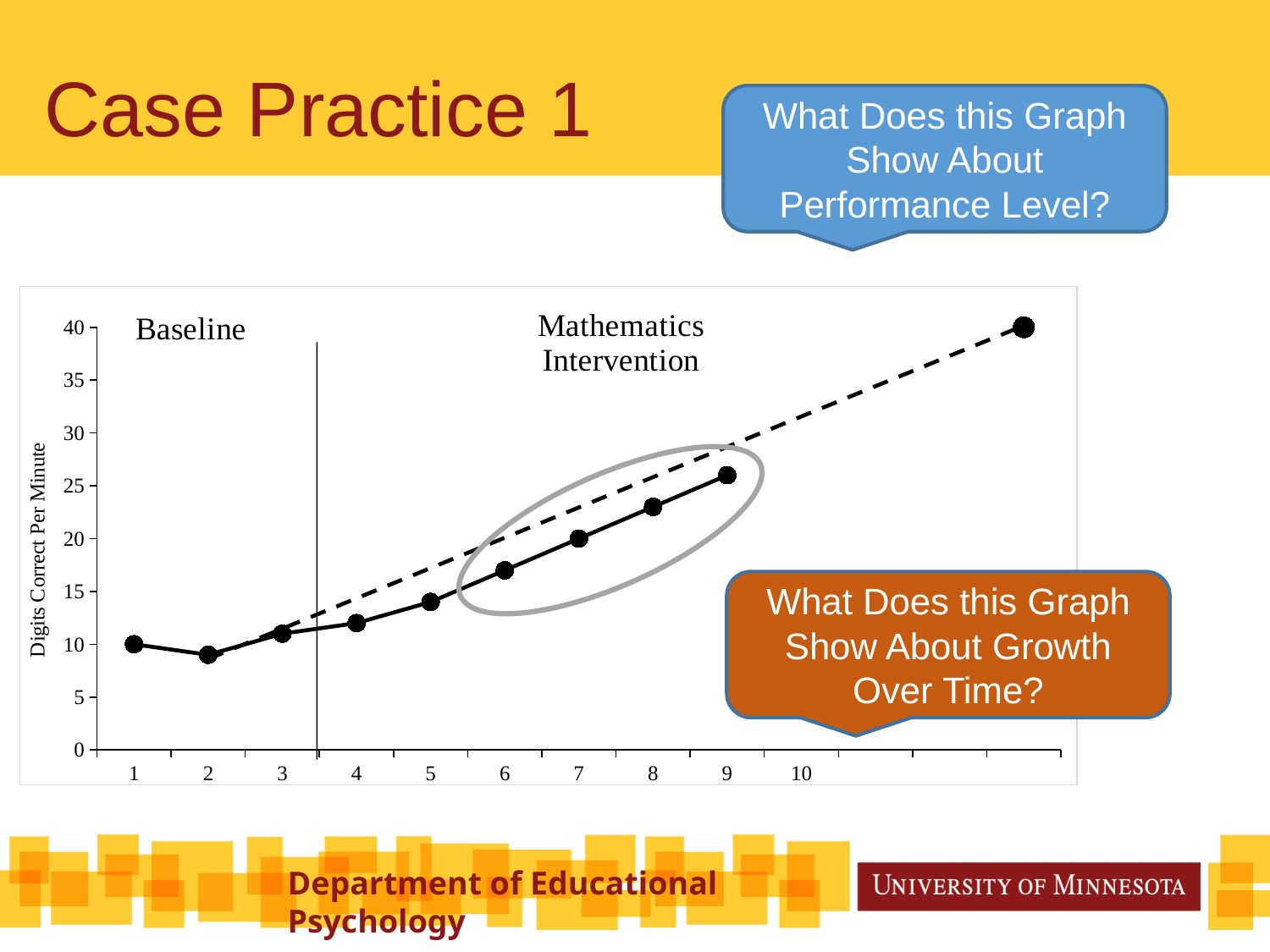
What type of chart is shown on the slide? line chart What is the value of the data point at session 7? 20 What value does the dashed goal line reach at its endpoint? 40 How many data points are plotted on the solid line? 9 Is the value at session 2 greater or less than 10? less Is the value at session 9 greater or less than 25? greater What is the label on the y axis of the chart? Digits Correct Per Minute Do the values on the solid line generally rise or fall during the Mathematics Intervention phase? rise Which session has the lowest value on the solid line? 2 What is the value of the first data point (session 1)? 10 Is the value at session 5 greater or less than 15? less What are the two phases labelled on the chart? Baseline and Mathematics Intervention